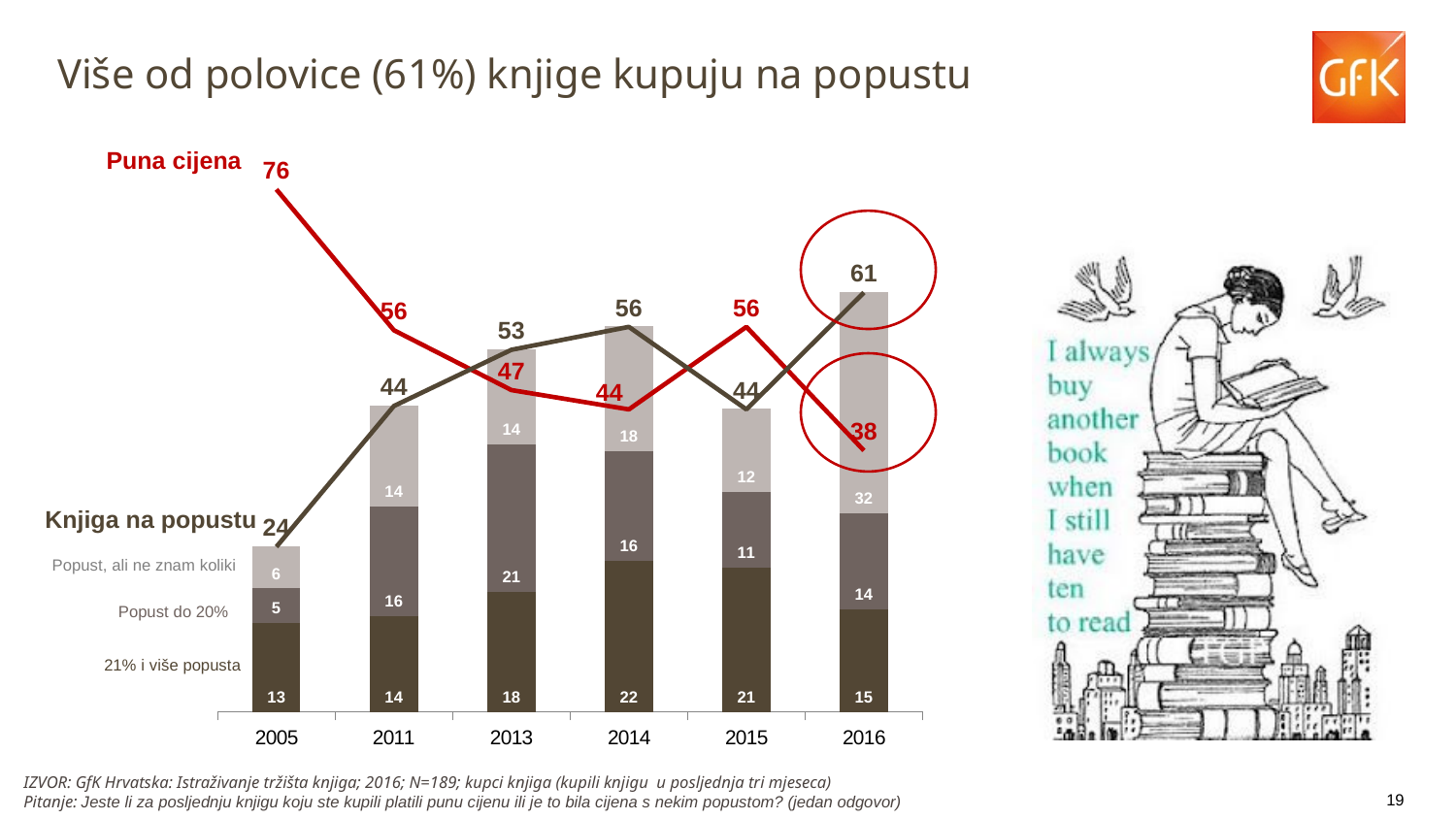
What is the value of the 'Knjiga na popustu' line for 2016? 61 Does the 'Puna cijena' line generally rise or fall from 2005 to 2016? Fall What is the difference between the 'Puna cijena' values for 2005 and 2016? 38 What is the value of the 'Popust do 20%' segment for 2013? 21 In which year is the 'Puna cijena' line at its lowest? 2016 How many years are shown on the x axis? 6 What is the value of the 'Puna cijena' line for 2005? 76 What kind of chart is shown on the slide? Combined stacked bar and line chart Which is larger in 2015: the 'Puna cijena' value or the 'Knjiga na popustu' value? Puna cijena What is the value of the '21% i više popusta' segment for 2014? 22 What is the value of the 'Popust, ali ne znam koliki' segment for 2016? 32 In which year is the 'Knjiga na popustu' line at its highest? 2016